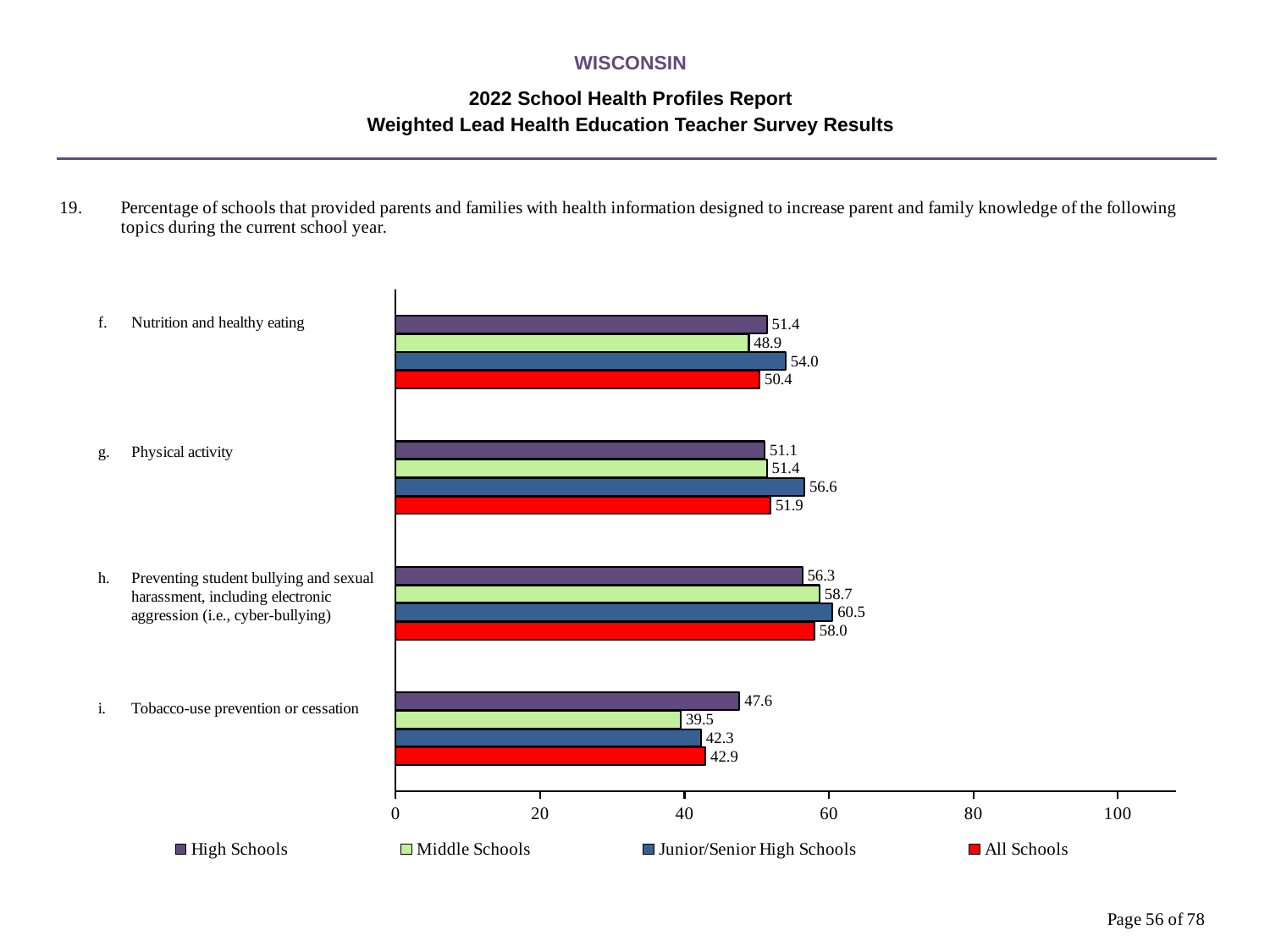
Is the value for Junior/Senior High Schools for Preventing student bullying and sexual harassment greater or less than 60? greater How many series does the legend list? 4 Which topic has the lowest value for Middle Schools? Tobacco-use prevention or cessation Which is larger for Nutrition and healthy eating: the High Schools value or the Junior/Senior High Schools value? Junior/Senior High Schools Which topic has the highest value for All Schools? Preventing student bullying and sexual harassment, including electronic aggression (i.e., cyber-bullying) What is the difference between the High Schools and Middle Schools values for Tobacco-use prevention or cessation? 8.1 What is the value for Middle Schools for Nutrition and healthy eating? 48.9 How many topics are shown on the chart? 4 What kind of chart is shown on the slide? Bar chart What is the value for All Schools for Tobacco-use prevention or cessation? 42.9 What colour are the All Schools bars? Red What is the value for Junior/Senior High Schools for Physical activity? 56.6